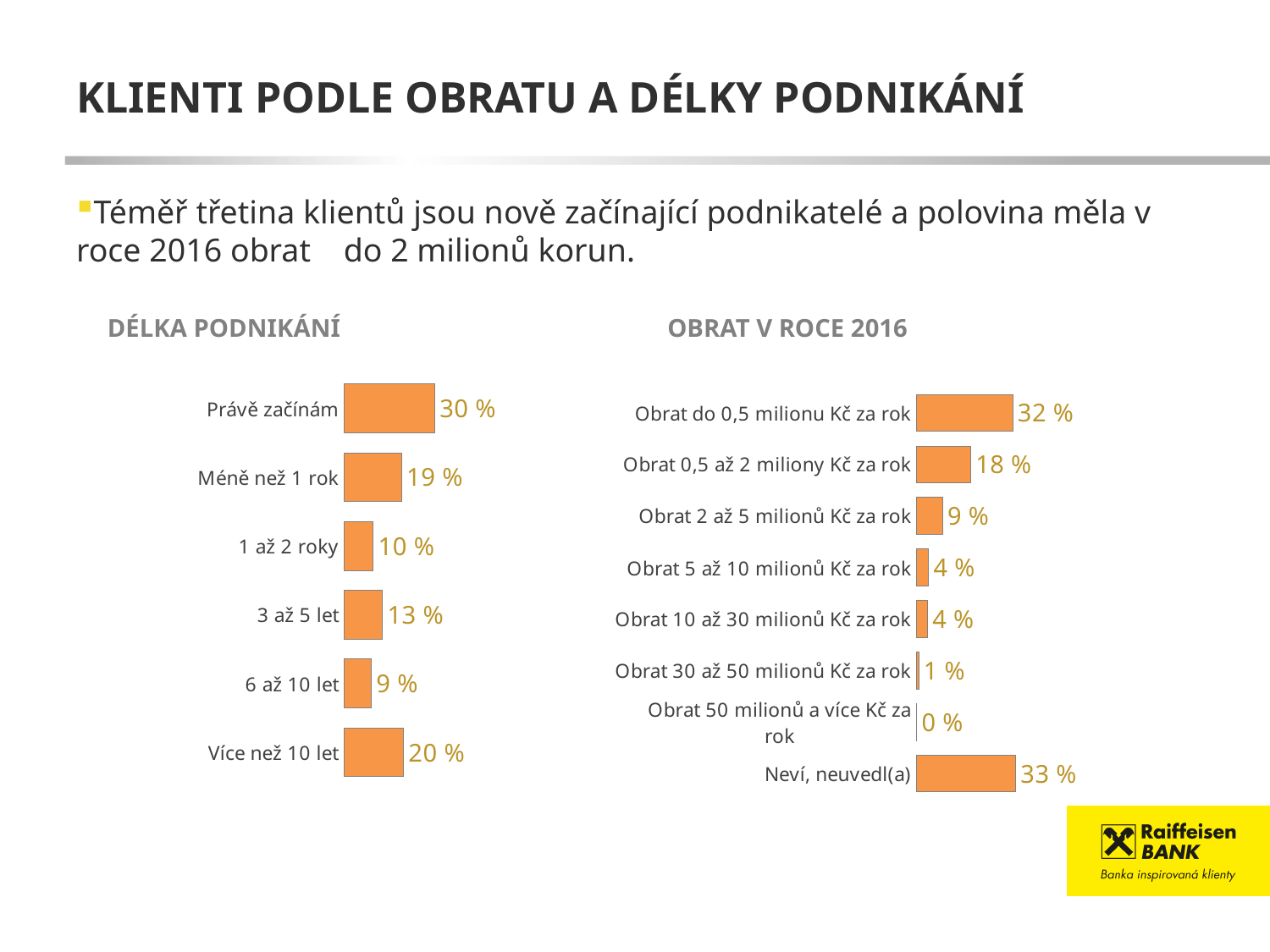
In the OBRAT V ROCE 2016 chart, which category has the lowest value? Obrat 50 milionů a více Kč za rok What type of chart is the OBRAT V ROCE 2016 chart? Bar chart In the DÉLKA PODNIKÁNÍ chart, which category has the highest value? Právě začínám In the DÉLKA PODNIKÁNÍ chart, what is the difference between "Méně než 1 rok" and "1 až 2 roky"? 9 % In the OBRAT V ROCE 2016 chart, what is the value for "Neví, neuvedl(a)"? 33 % In the OBRAT V ROCE 2016 chart, what is the value for "Obrat 0,5 až 2 miliony Kč za rok"? 18 % In the OBRAT V ROCE 2016 chart, which is larger: "Obrat 2 až 5 milionů Kč za rok" or "Obrat 5 až 10 milionů Kč za rok"? Obrat 2 až 5 milionů Kč za rok In the DÉLKA PODNIKÁNÍ chart, how many categories are shown? 6 In the DÉLKA PODNIKÁNÍ chart, what is the value for "Více než 10 let"? 20 % In the OBRAT V ROCE 2016 chart, how many categories are shown? 8 In the DÉLKA PODNIKÁNÍ chart, what is the value for "Právě začínám"? 30 % In the DÉLKA PODNIKÁNÍ chart, which category has the lowest value? 6 až 10 let